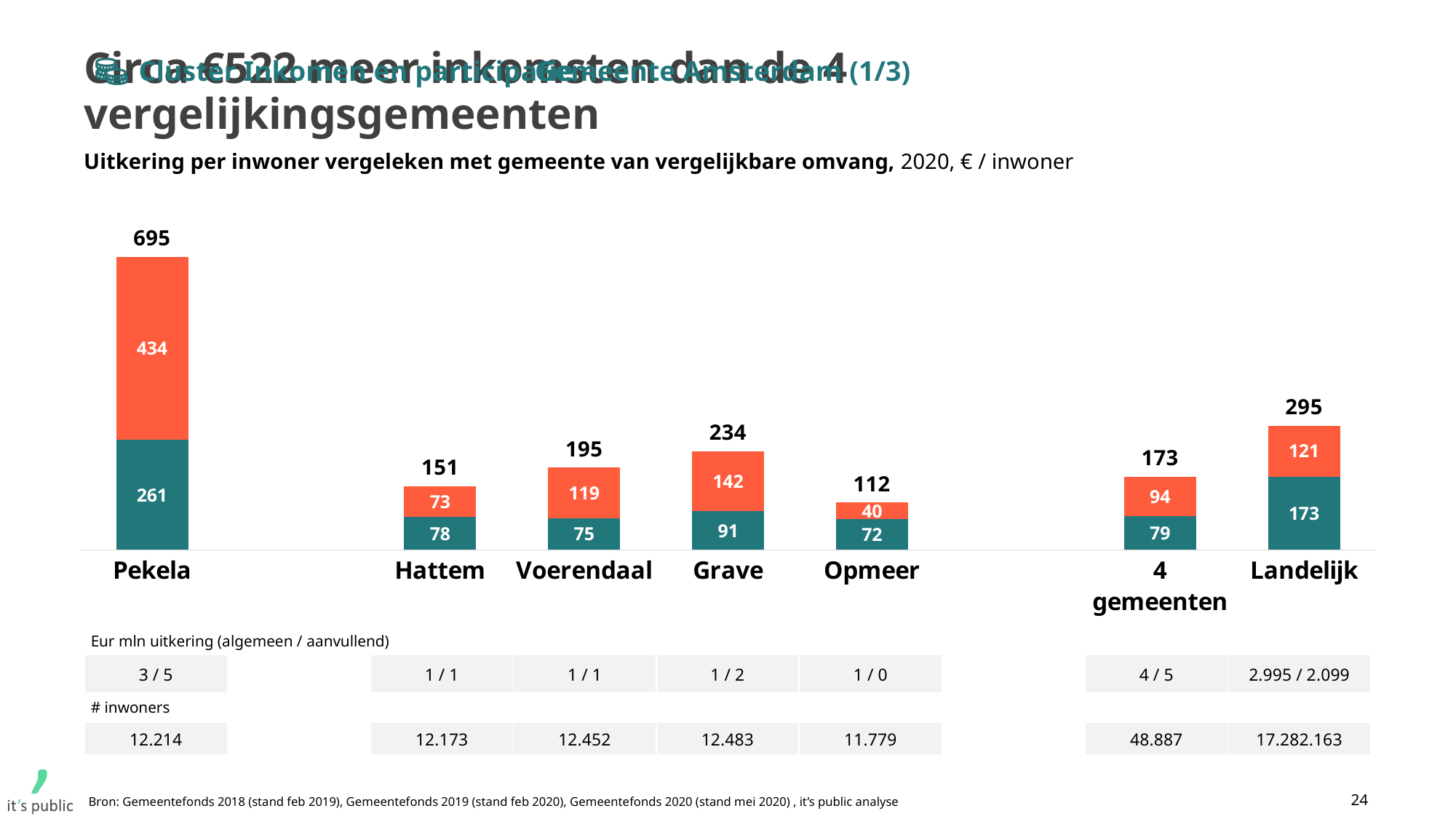
How many categories are shown on the x axis of the chart? 7 Which has a larger total, Grave or Voerendaal? Grave What is the value of the top (orange) segment of the Landelijk bar? 121 In what unit are the chart values expressed, according to the subtitle? € / inwoner What is the value of the bottom (teal) segment of the Pekela bar? 261 What is the value of the top (orange) segment of the Opmeer bar? 40 Which category has the highest total bar? Pekela Which category has the lowest total bar? Opmeer What is the difference between the total for Pekela and the total for Landelijk? 400 What is the difference between the total for Pekela and the total for 4 gemeenten? 522 What is the total value shown above the bar for Pekela? 695 What kind of chart is shown on the slide? Stacked bar chart